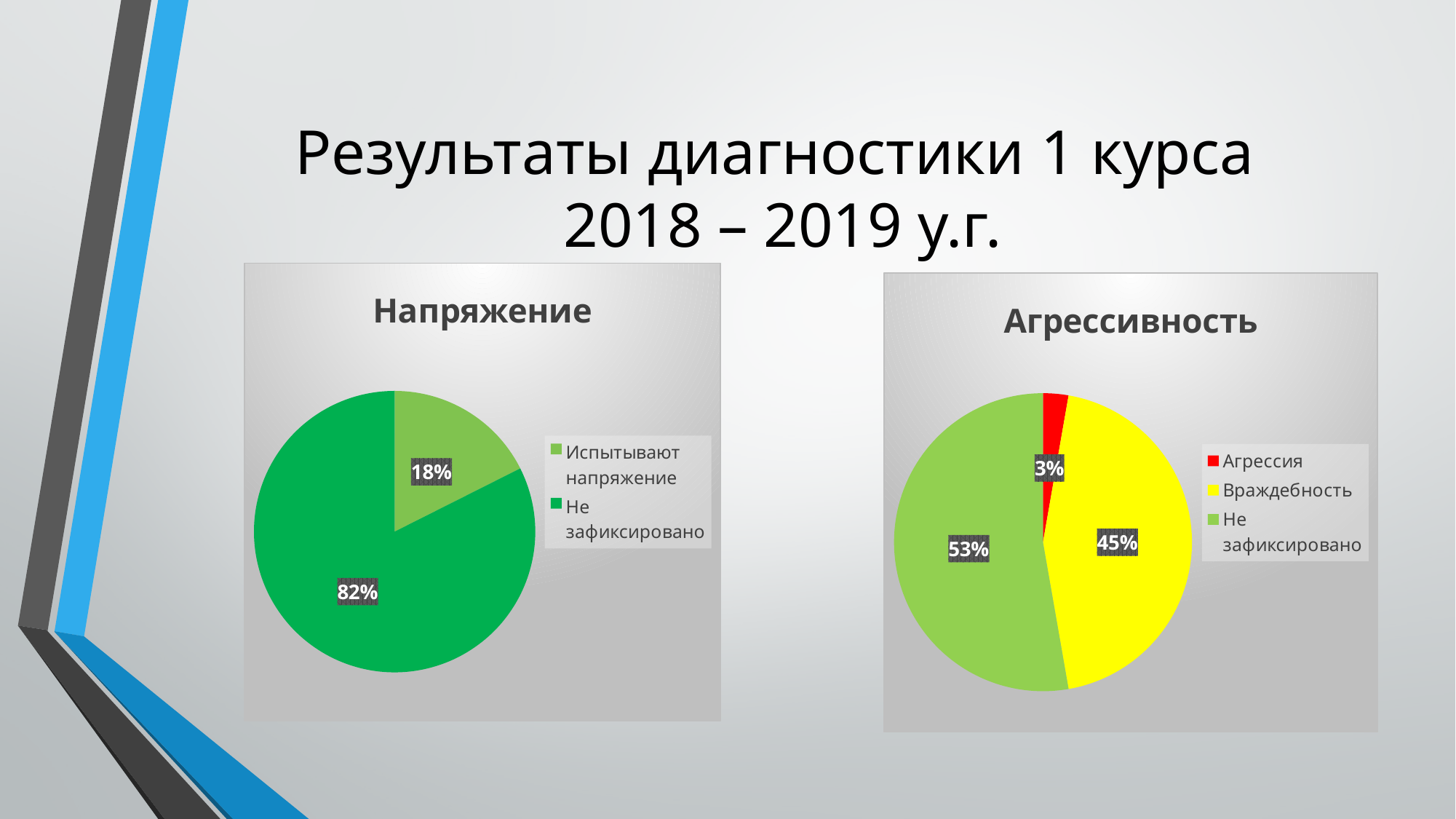
In the "Агрессивность" chart, which slice is the smallest? Агрессия In the "Агрессивность" chart, what is the difference between the "Не зафиксировано" and "Враждебность" shares? 8% In the "Агрессивность" chart, what share is labelled for "Агрессия"? 3% In the "Агрессивность" chart, what share is labelled for "Враждебность"? 45% In the "Агрессивность" chart, which is larger: "Враждебность" or "Не зафиксировано"? Не зафиксировано In the "Агрессивность" chart, what share is labelled for "Не зафиксировано"? 53% In the "Напряжение" chart, which slice is the largest? Не зафиксировано In the "Напряжение" chart, what is the difference between the "Не зафиксировано" and "Испытывают напряжение" shares? 64% How many slices does the "Агрессивность" chart have? 3 In the "Напряжение" chart, what share is labelled for "Не зафиксировано"? 82% In the "Напряжение" chart, what share is labelled for "Испытывают напряжение"? 18% What type of chart is the "Напряжение" chart? Pie chart